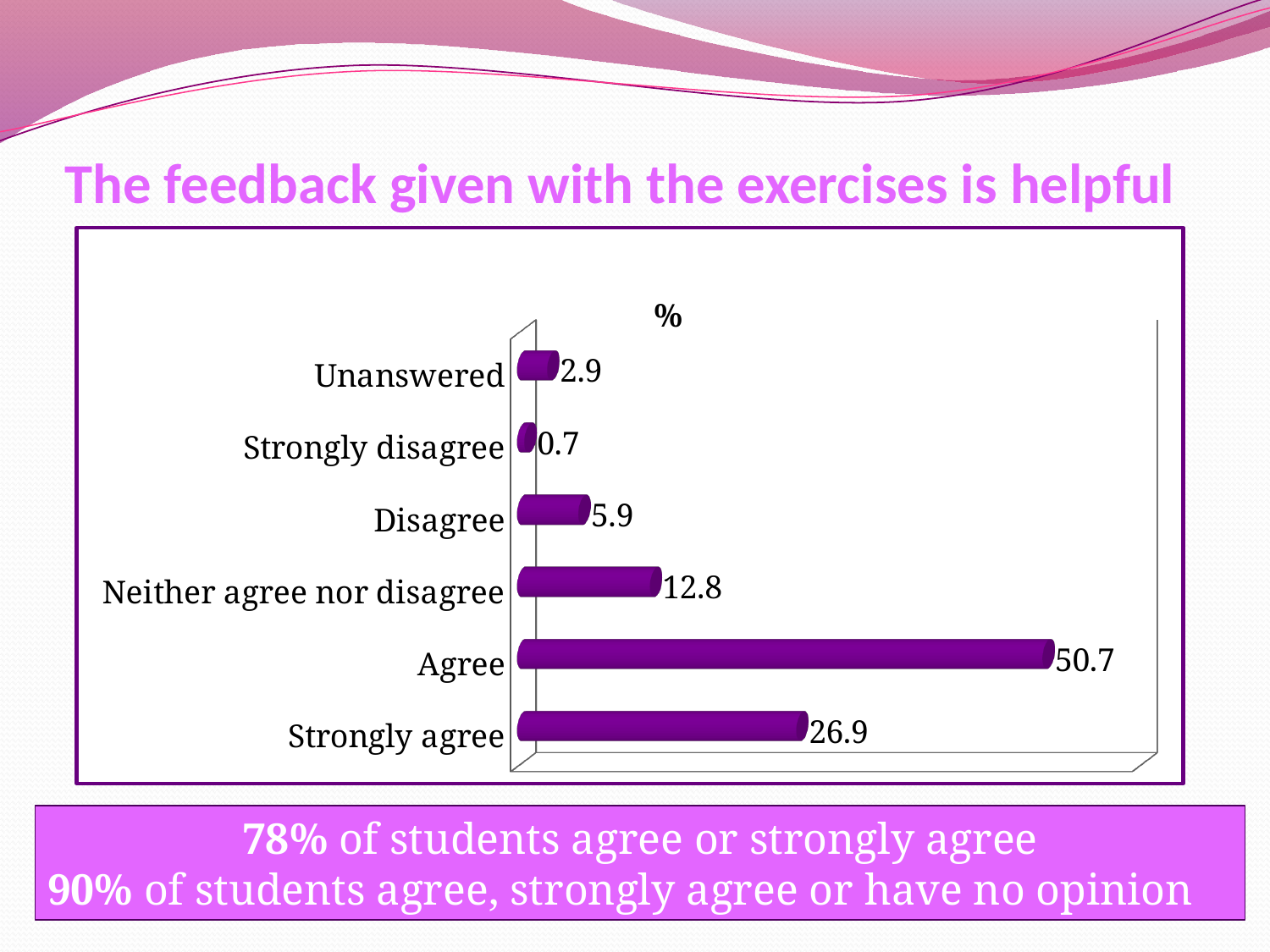
What is the difference between the values for Agree and Strongly agree? 23.8 What is the value for Strongly disagree? 0.7 What kind of chart is shown on the slide? Bar chart Which is larger, the value for Disagree or the value for Unanswered? Disagree Which category has the lowest value? Strongly disagree What is the value for Agree? 50.7 What is the value for Neither agree nor disagree? 12.8 What is the value for Strongly agree? 26.9 How many categories are shown in the chart? 6 What is the value for Unanswered? 2.9 Which category has the highest value? Agree What is the title of the chart? %